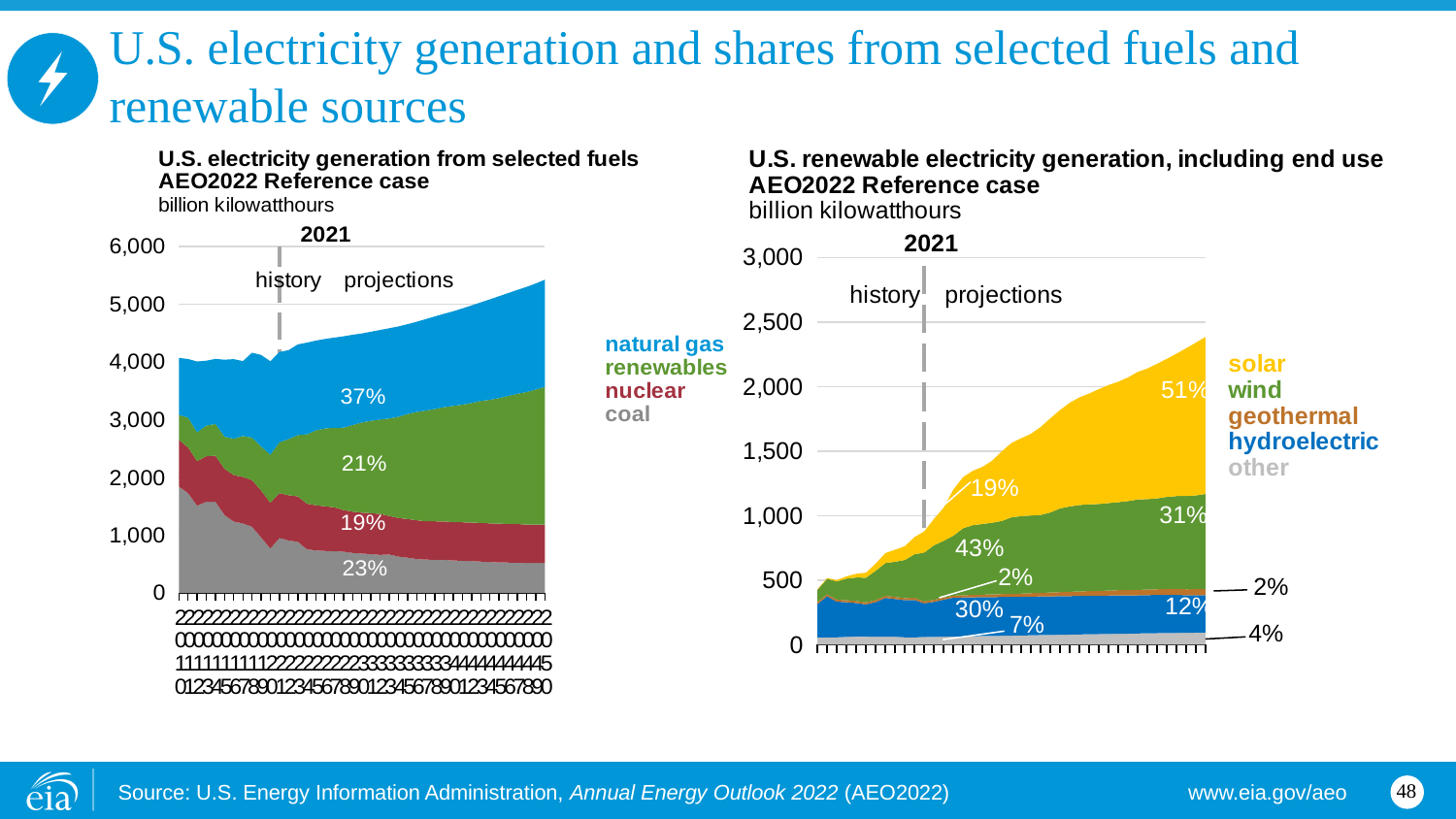
In the right chart, 'U.S. renewable electricity generation, including end use', what percentage label is shown for wind near the 2021 line? 43% How many series does the legend of the right chart, 'U.S. renewable electricity generation, including end use', list? 5 How many series does the legend of the left chart, 'U.S. electricity generation from selected fuels', list? 4 What kind of chart is the left chart, 'U.S. electricity generation from selected fuels'? stacked area chart In the right chart, 'U.S. renewable electricity generation, including end use', is the total renewable generation at the end of the projection period greater or less than 2,000 billion kilowatthours? greater In the right chart, 'U.S. renewable electricity generation, including end use', which has the larger share label at the right edge: solar or wind? solar In the left chart, 'U.S. electricity generation from selected fuels', what percentage label is shown on the natural gas area? 37% In the right chart, 'U.S. renewable electricity generation, including end use', does total renewable generation rise or fall over the projection period? rise What unit is shown on the y axis of both charts? billion kilowatthours In the left chart, 'U.S. electricity generation from selected fuels', what percentage label is shown on the coal area? 23% In the right chart, 'U.S. renewable electricity generation, including end use', what is the difference between the solar (51%) and wind (31%) labels at the right edge? 20 percentage points In the right chart, 'U.S. renewable electricity generation, including end use', what percentage label appears at the right edge of the solar area? 51%